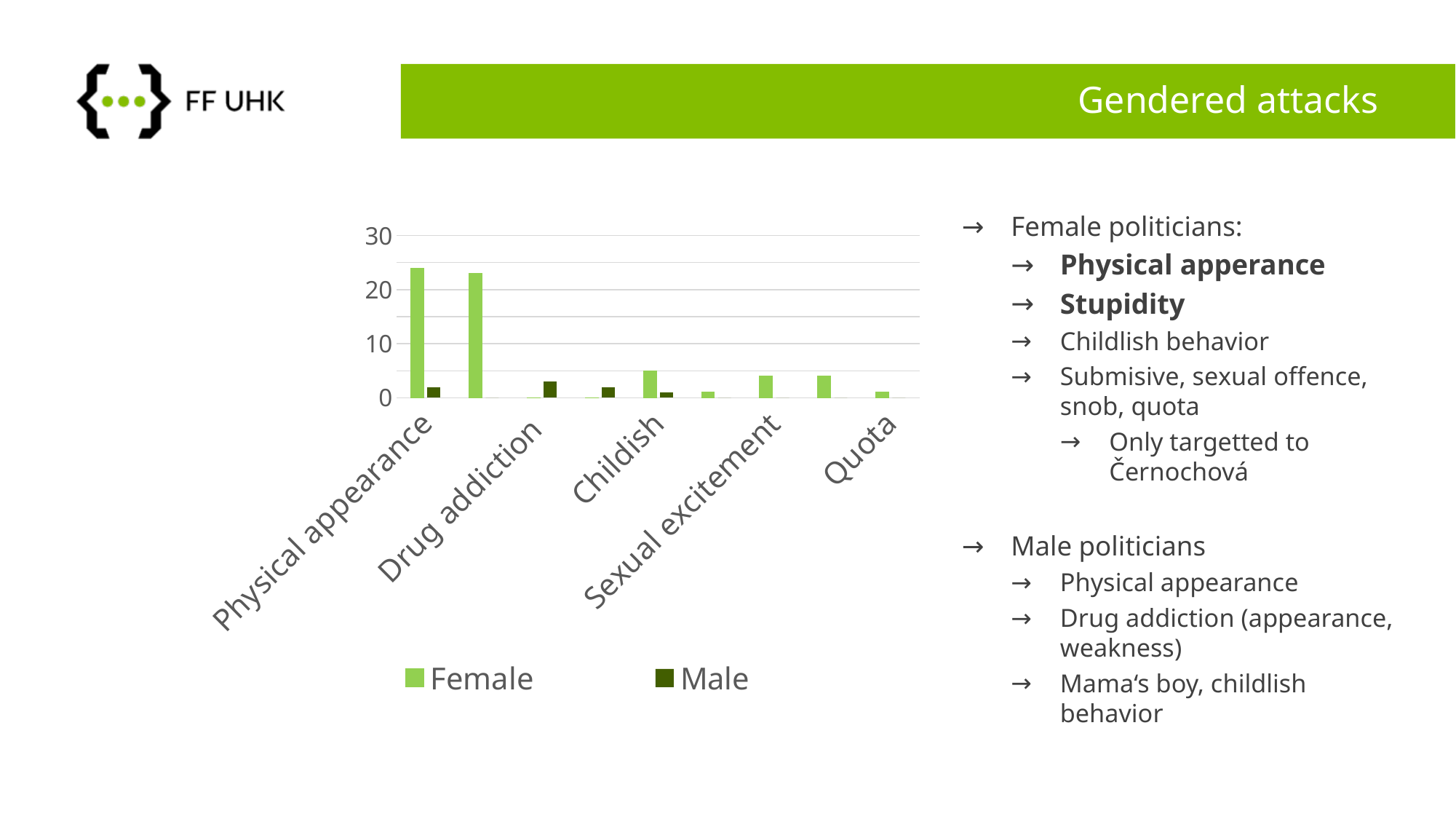
Is the Female value for Physical appearance greater or less than 20? greater For Drug addiction, which series has the larger value, Female or Male? Male Is the Female value for Physical appearance greater or less than 30? less What kind of chart is shown on the slide? bar chart Which series is drawn in the darker green colour? Male Among the labelled categories on the x axis, which has the highest Female value? Physical appearance What are the two series named in the chart's legend? Female and Male For Physical appearance, which series has the larger value, Female or Male? Female For Childish, which series has the larger value, Female or Male? Female How many series does the chart's legend list? 2 Is the Female value for Childish greater or less than 10? less